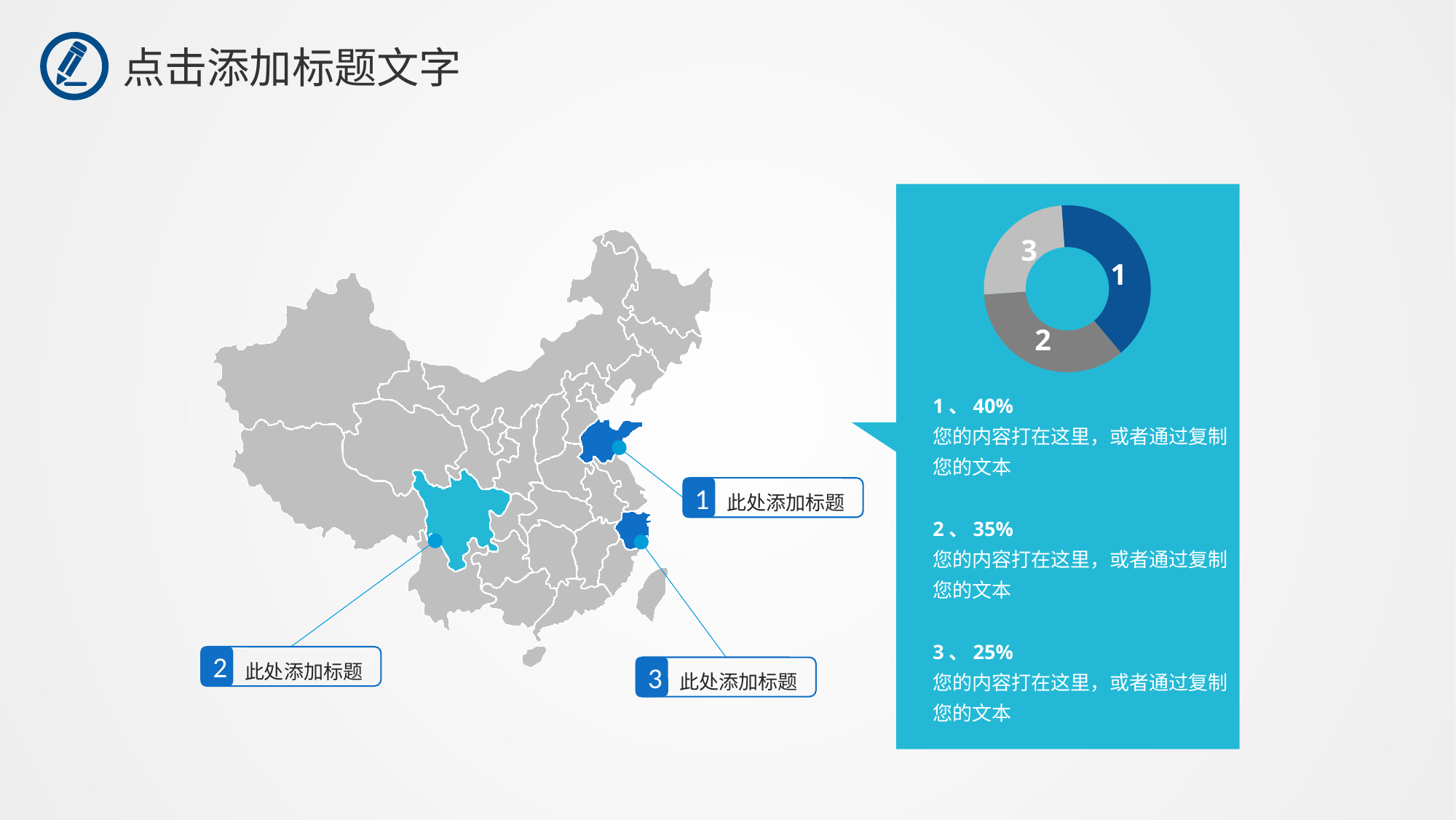
What percentage is given for segment 1 of the donut chart? 40% Which is larger, segment 2 or segment 3 of the donut chart? 2 Which segment of the donut chart has the largest share? 1 What colour is segment 3 of the donut chart? light grey What is the difference in percentage points between segment 2 and segment 3? 10% How many segments does the donut chart have? 3 What is the difference in percentage points between segment 1 and segment 3? 15% What colour is segment 1 of the donut chart? dark blue What percentage is given for segment 3 of the donut chart? 25% What percentage is given for segment 2 of the donut chart? 35% What kind of chart is shown on the slide? donut chart Which segment of the donut chart has the smallest share? 3